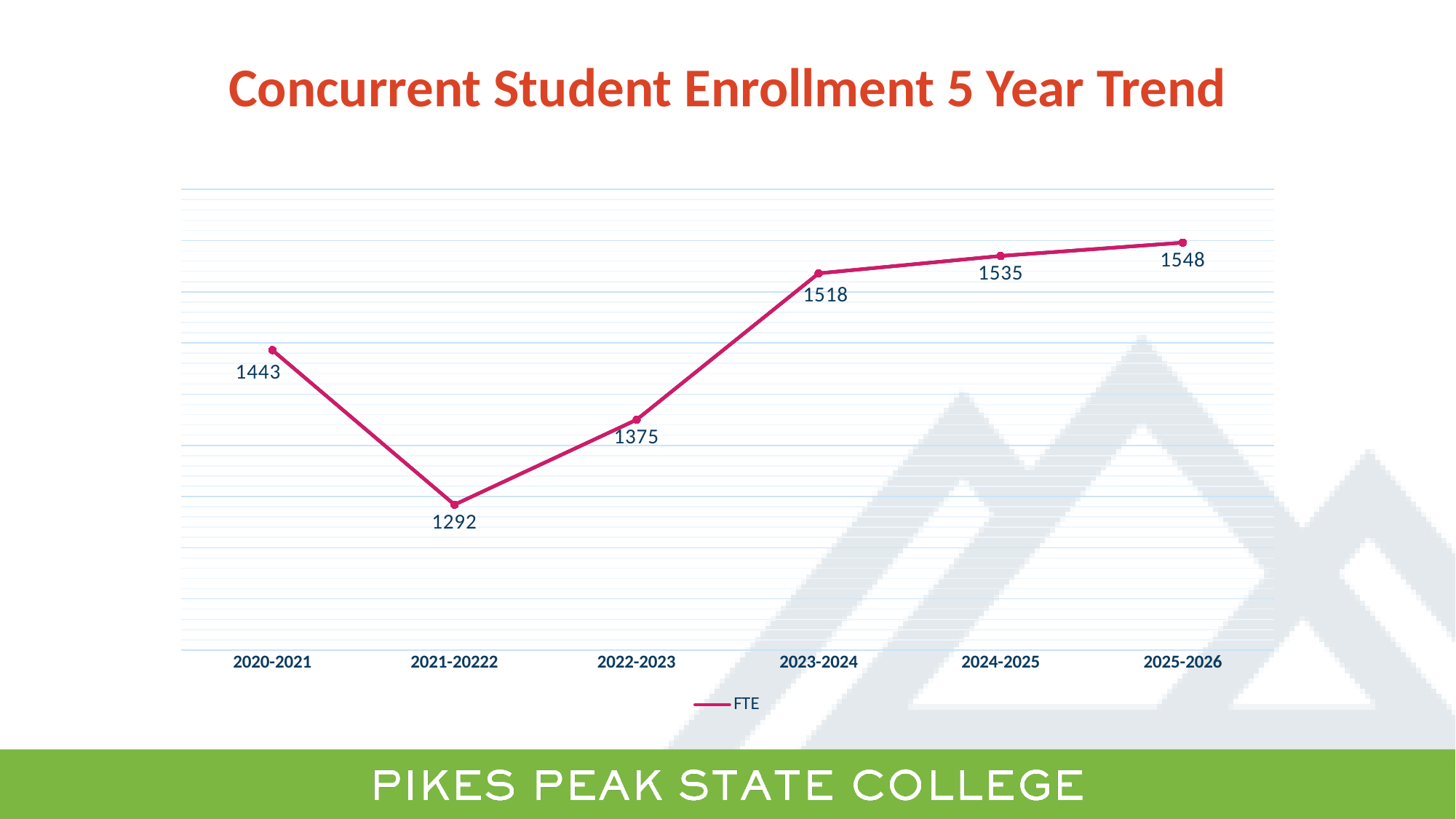
What is the FTE value for 2023-2024? 1518 What is the title of the chart? Concurrent Student Enrollment 5 Year Trend What is the difference between the FTE values for 2025-2026 and 2020-2021? 105 Which is larger, the FTE value for 2020-2021 or for 2022-2023? 2020-2021 What is the FTE value for 2020-2021? 1443 What is the difference between the FTE values for 2023-2024 and 2022-2023? 143 Which year has the highest FTE value? 2025-2026 What kind of chart is shown on the slide? Line chart What is the FTE value for 2021-20222? 1292 How many years are plotted on the chart? 6 Which year has the lowest FTE value? 2021-20222 What is the FTE value for 2025-2026? 1548